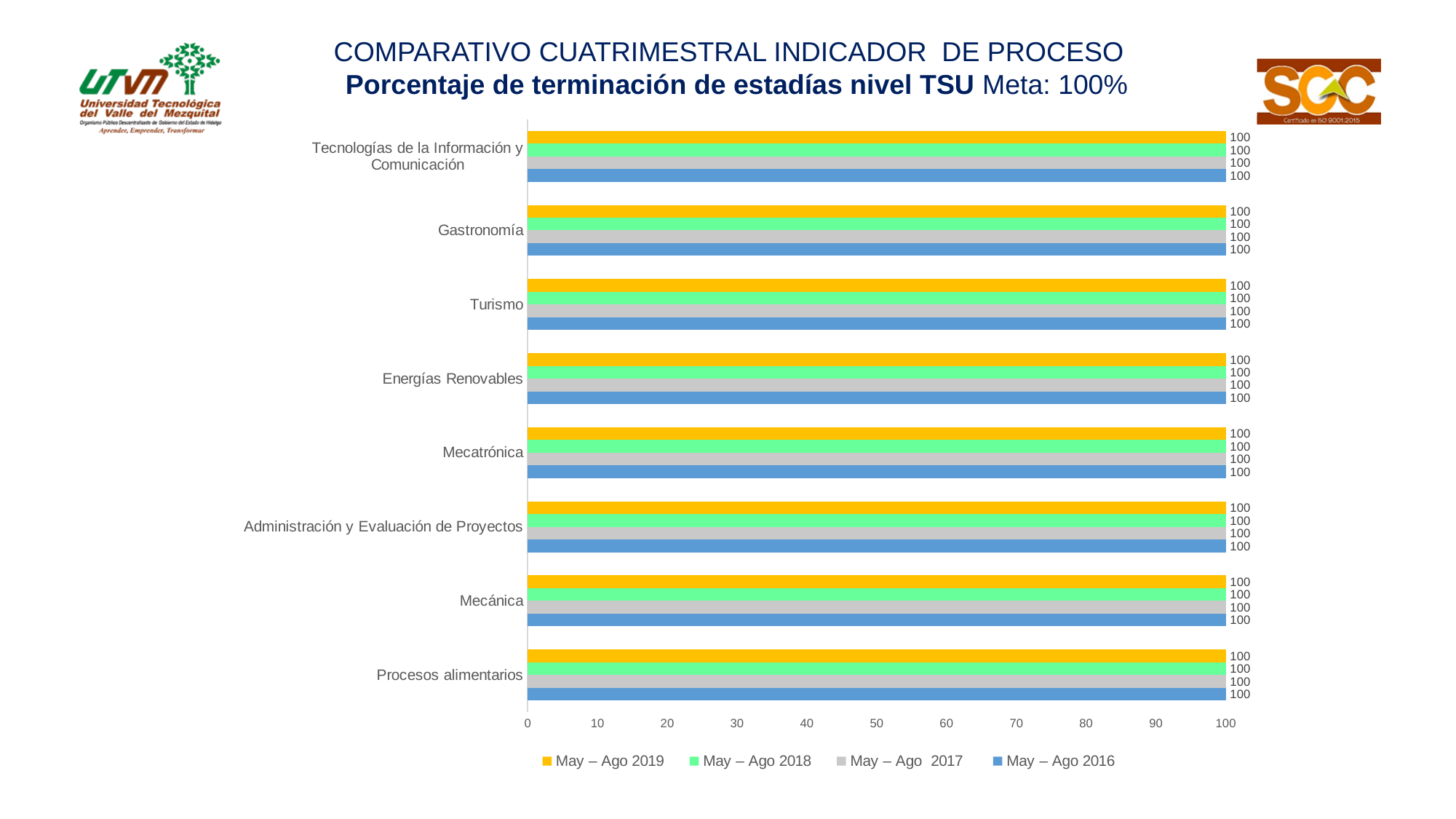
How many series does the legend list? 4 Is the value for Energías Renovables in the May – Ago 2018 series greater or less than 90? greater What is the target (Meta) stated in the chart title? 100% What kind of chart is shown on the slide? Bar chart What is the value for Administración y Evaluación de Proyectos in the May – Ago 2017 series? 100 Which series is shown in yellow according to the legend? May – Ago 2019 How many categories (programs) are shown on the chart? 8 What is the difference between the May – Ago 2019 and May – Ago 2016 values for Mecatrónica? 0 What is the value for Turismo in the May – Ago 2018 series? 100 What is the value for Gastronomía in the May – Ago 2019 series? 100 What is the value for Procesos alimentarios in the May – Ago 2017 series? 100 What is the value for Mecánica in the May – Ago 2016 series? 100